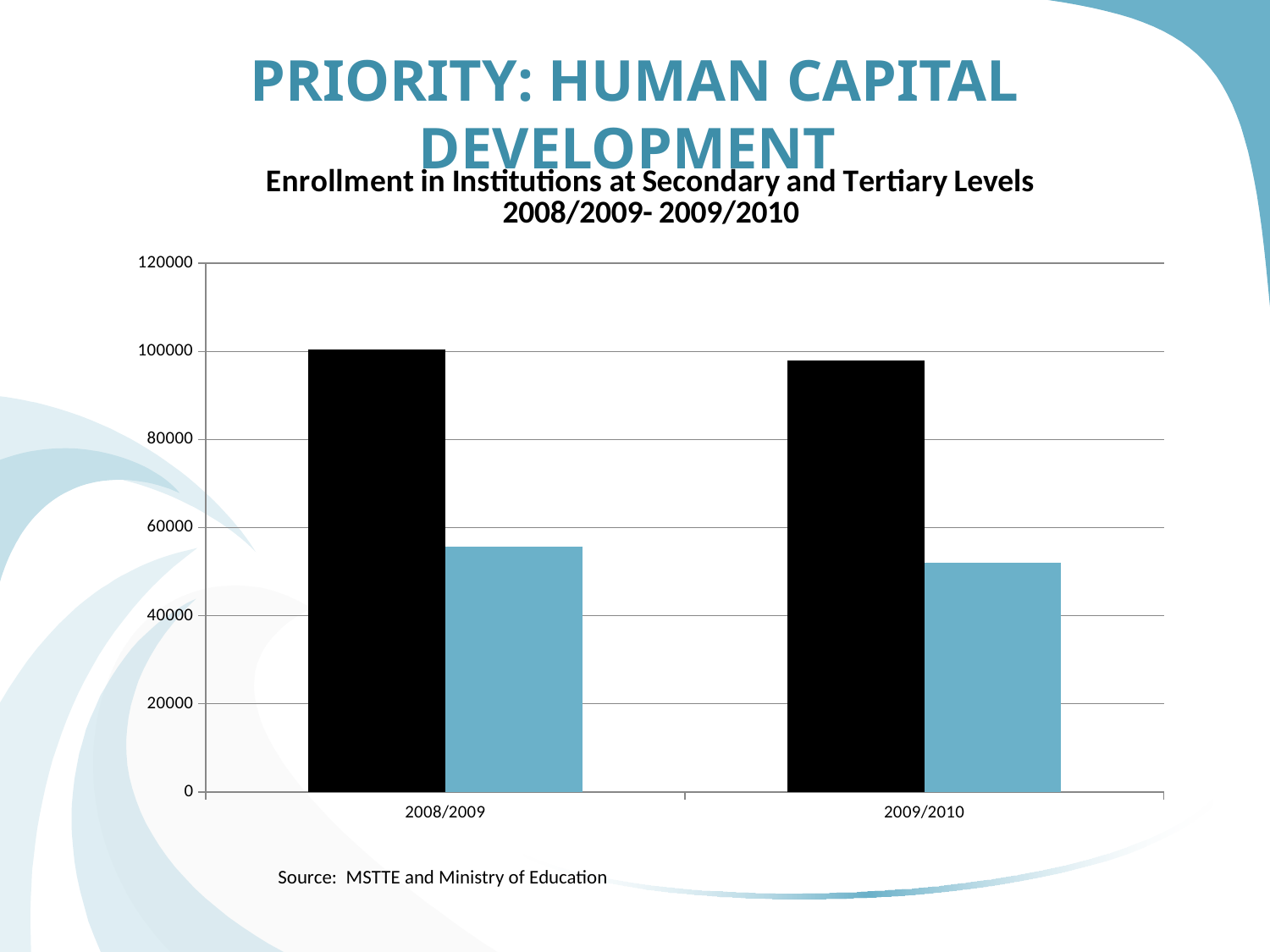
Which is larger in 2008/2009, the black bar or the blue bar? The black bar Is the value of the black bar for 2008/2009 greater or less than 80000? greater How many academic years are shown on the x axis of the chart? 2 How many bars are plotted for each academic year? 2 Is the value of the blue bar for 2008/2009 greater or less than 60000? less Which academic year has the taller black bar, 2008/2009 or 2009/2010? 2008/2009 What kind of chart is shown on the slide? Bar chart Do the blue bars rise or fall from 2008/2009 to 2009/2010? Fall What source is cited below the chart? MSTTE and Ministry of Education Is the value of the blue bar for 2009/2010 greater or less than 40000? greater What is the title of the chart? Enrollment in Institutions at Secondary and Tertiary Levels 2008/2009- 2009/2010